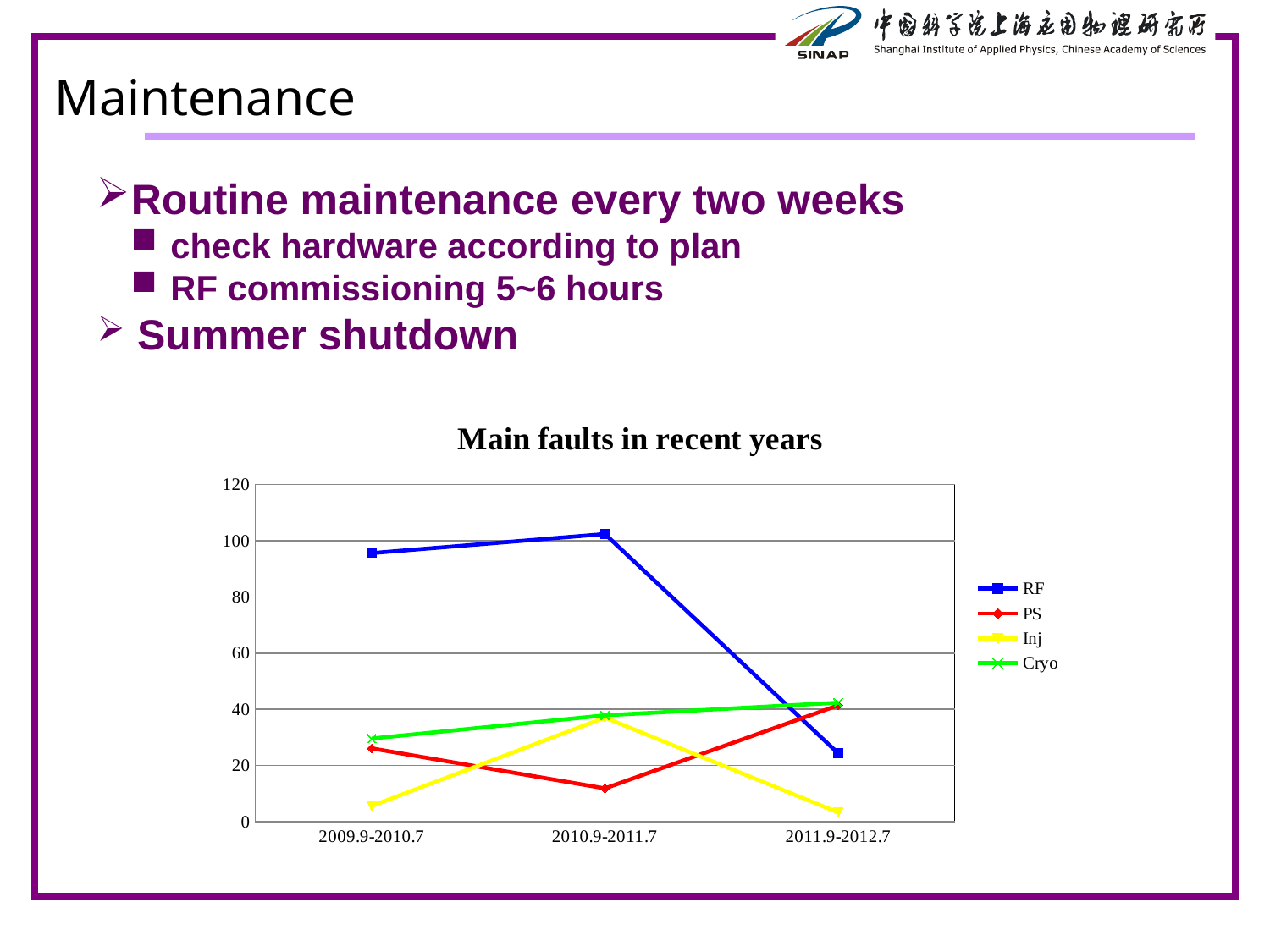
Which series has the lowest value in 2010.9-2011.7? PS What is the title of the chart? Main faults in recent years Is the RF value for 2011.9-2012.7 greater or less than 40? less Which series has the highest value in 2009.9-2010.7? RF Which series has the lowest value in 2009.9-2010.7? Inj Does the Cryo series rise or fall from 2009.9-2010.7 to 2011.9-2012.7? rise Is the RF value for 2009.9-2010.7 greater or less than 80? greater How many periods are shown on the x axis of the chart? 3 Which is larger in 2010.9-2011.7, the Inj value or the PS value? Inj How many series does the chart legend list? 4 Which series has the lowest value in 2011.9-2012.7? Inj What type of chart is shown on the slide? line chart